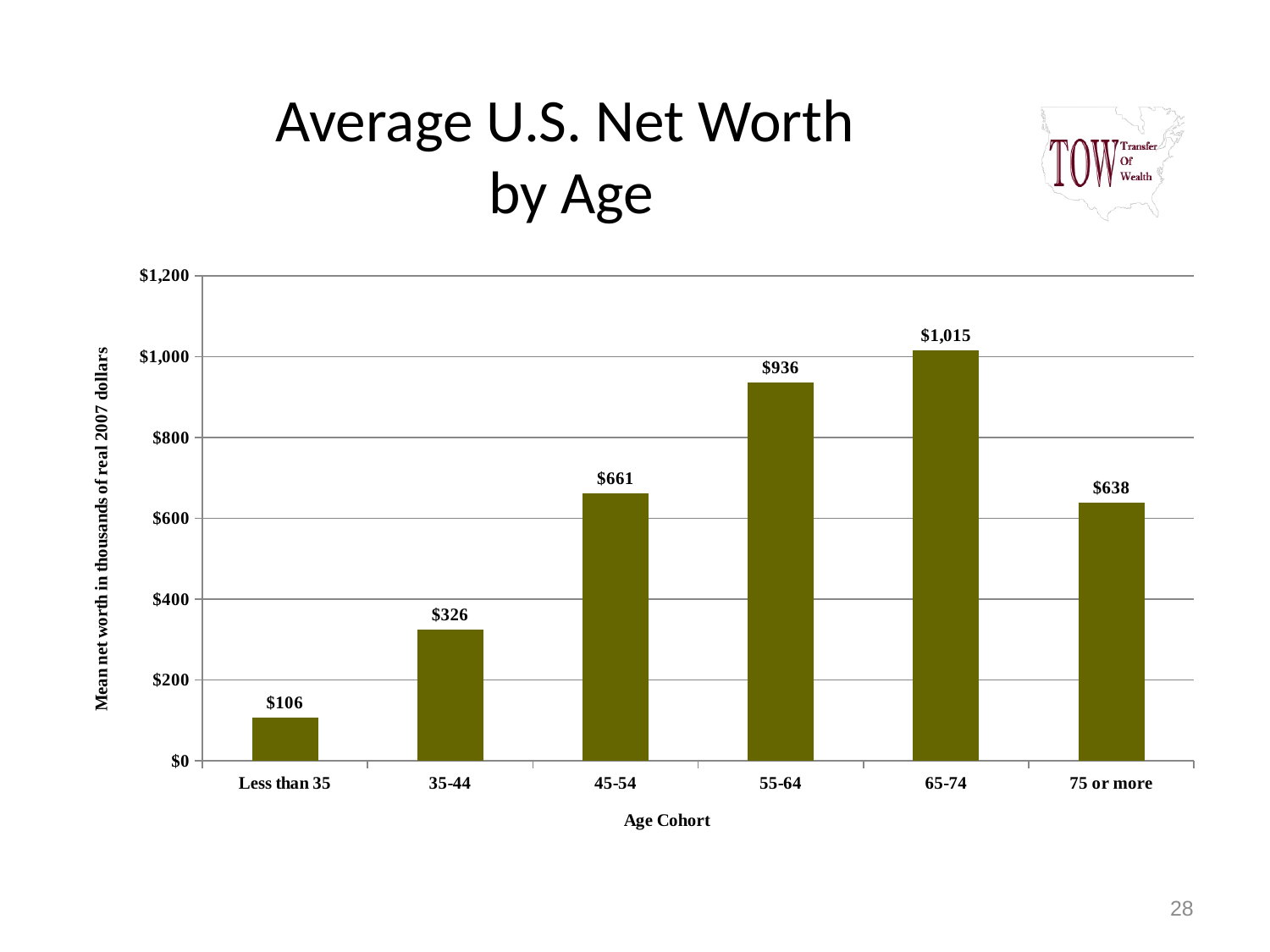
What is the mean net worth for the 45-54 age cohort? $661 What is the difference in mean net worth between the 65-74 and 55-64 cohorts? $79 How many age cohorts are shown on the chart? 6 What is the label of the x axis? Age Cohort Is the value for the 55-64 cohort greater or less than $800? greater Which age cohort has the lowest mean net worth? Less than 35 What is the difference in mean net worth between the 45-54 and 35-44 cohorts? $335 What is the mean net worth for the 75 or more age cohort? $638 Which age cohort has the highest mean net worth? 65-74 What kind of chart is shown on the slide? Bar chart What is the mean net worth for the Less than 35 age cohort? $106 Which cohort has a higher mean net worth, 45-54 or 75 or more? 45-54